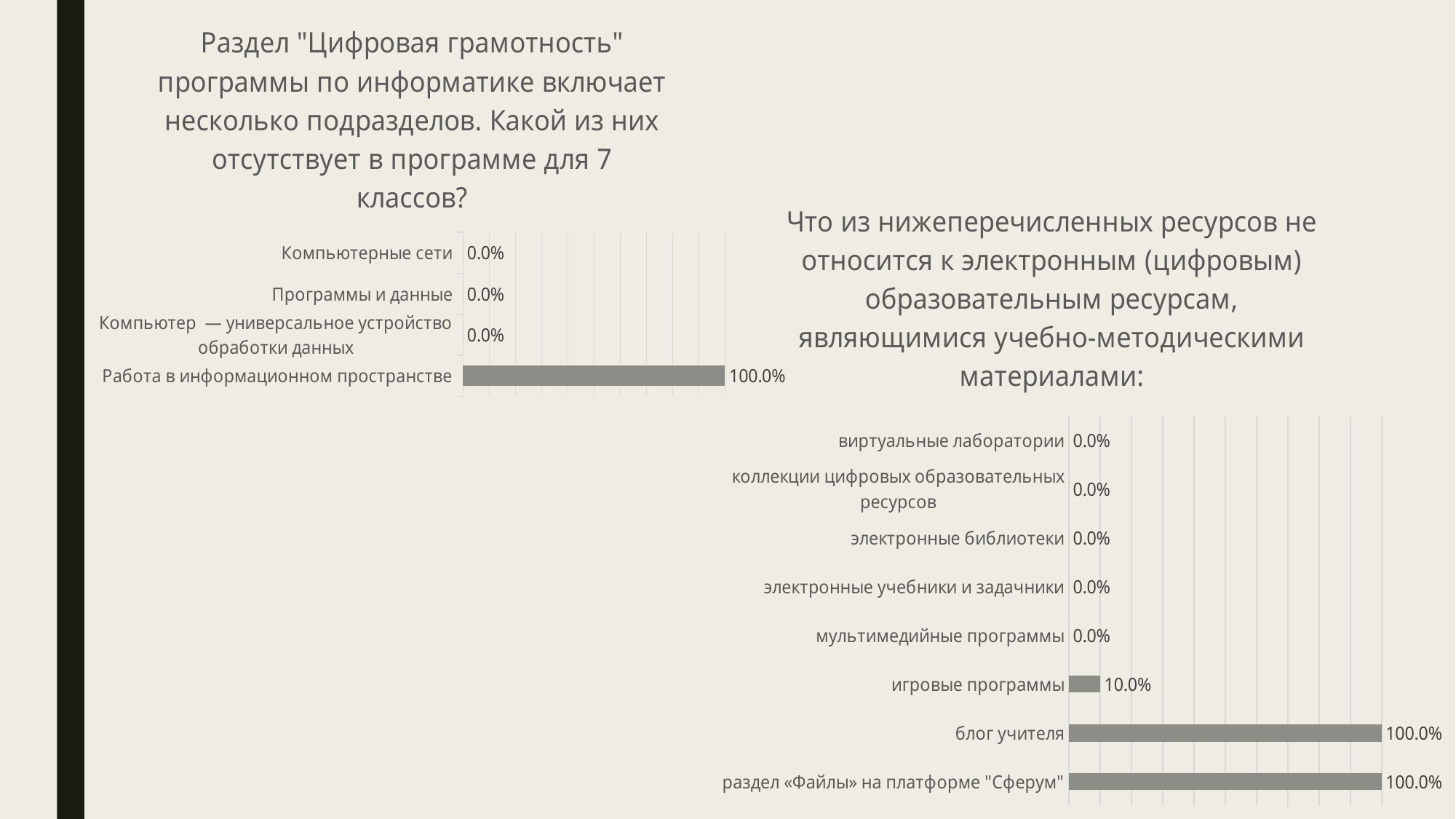
In the right chart, what is the value for "игровые программы"? 10.0% In the left chart, what is the value for "Работа в информационном пространстве"? 100.0% In the right chart, what is the value for "электронные библиотеки"? 0.0% How many categories are shown in the right chart? 8 What type of chart is the left chart? Bar chart In the right chart, which is larger: the value for "игровые программы" or the value for "мультимедийные программы"? игровые программы In the left chart, which category has the highest value? Работа в информационном пространстве How many categories are shown in the left chart? 4 In the left chart, what is the value for "Компьютерные сети"? 0.0% In the right chart, what is the difference between the values for "блог учителя" and "игровые программы"? 90.0% In the right chart, what is the value for "блог учителя"? 100.0% In the right chart, how many categories have a value of 100.0%? 2